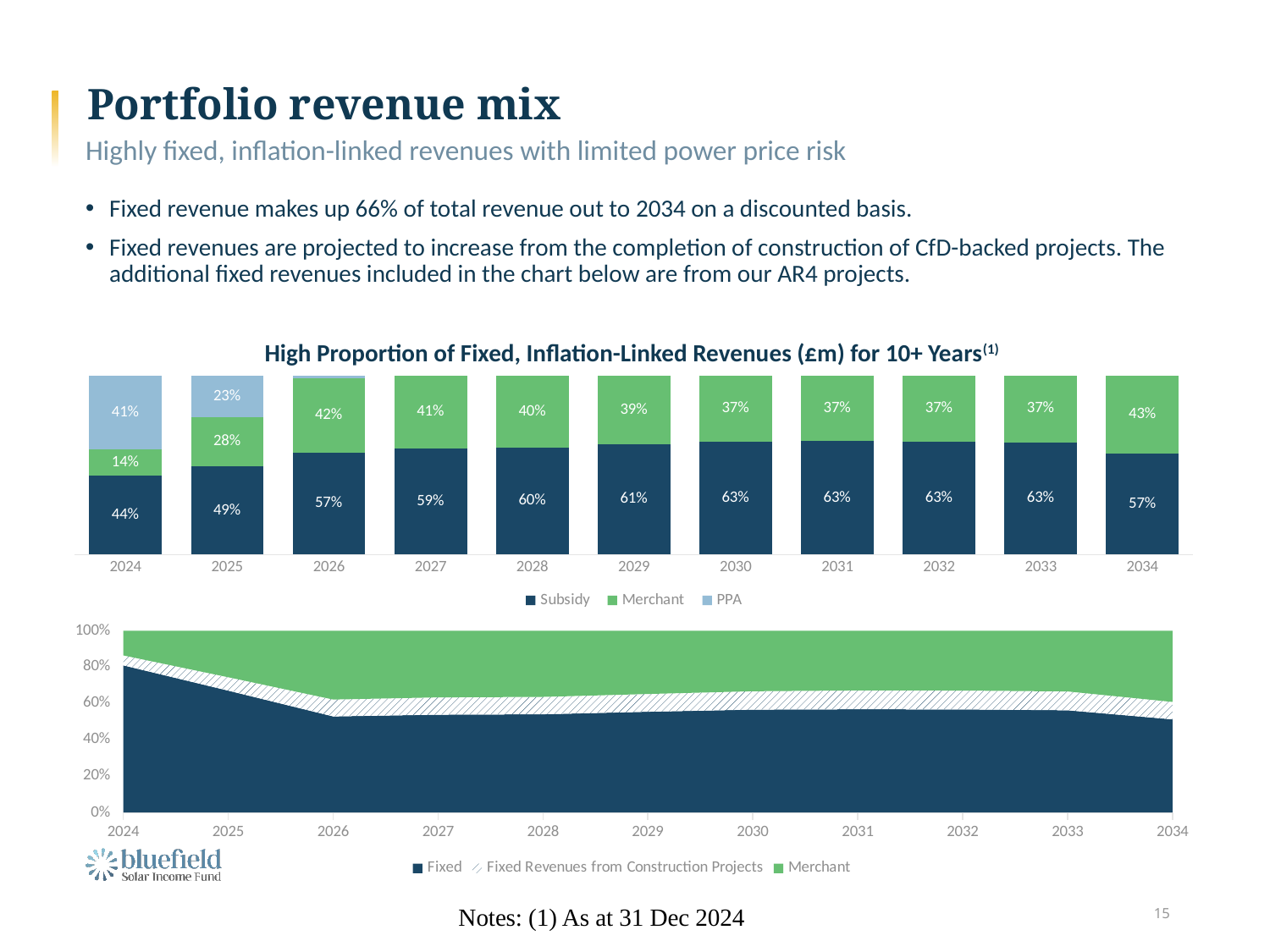
In the bottom area chart, is the Fixed share in 2024 greater or less than 60%? greater In the top bar chart, what is the PPA share for 2025? 23% In the top bar chart, what is the difference between the Subsidy share in 2034 and in 2024? 13 percentage points In the top bar chart, does the Subsidy share rise or fall from 2024 to 2030? Rises What kind of chart is the top chart titled 'High Proportion of Fixed, Inflation-Linked Revenues (£m) for 10+ Years'? Stacked bar chart What kind of chart is the bottom chart with the Fixed, Fixed Revenues from Construction Projects and Merchant legend? Stacked area chart In the top bar chart, what is the Merchant share for 2034? 43% In the top bar chart, is the Merchant share larger in 2026 or in 2027? 2026 In the top bar chart, which year has the lowest Subsidy share? 2024 How many years are shown on the x axis of the top bar chart? 11 In the top bar chart, what is the Subsidy share for 2024? 44% How many series does the legend of the top bar chart list? 3